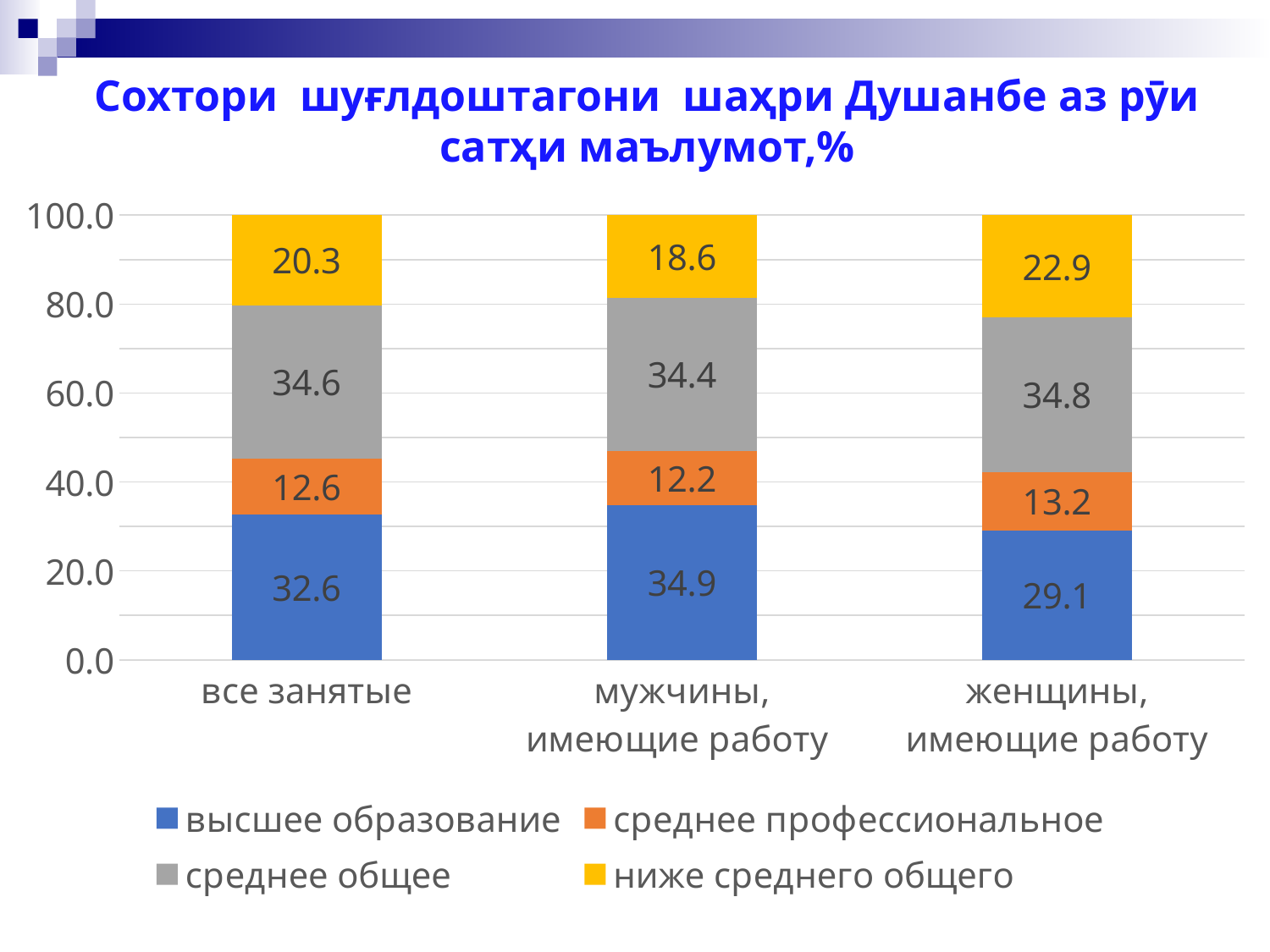
Which category has the lowest value for ниже среднего общего? мужчины, имеющие работу What is the value for высшее образование in the все занятые bar? 32.6 How many series does the legend list? 4 What is the difference between the высшее образование values for мужчины, имеющие работу and женщины, имеющие работу? 5.8 What is the value for ниже среднего общего in the женщины, имеющие работу bar? 22.9 Which has the larger среднее профессиональное value: женщины, имеющие работу or все занятые? женщины, имеющие работу What is the difference between the ниже среднего общего values for женщины, имеющие работу and все занятые? 2.6 What is the value for среднее профессиональное in the мужчины, имеющие работу bar? 12.2 How many categories are shown on the x axis? 3 Which category has the highest value for высшее образование? мужчины, имеющие работу What colour represents среднее общее in the legend? grey What kind of chart is shown on the slide? stacked bar chart